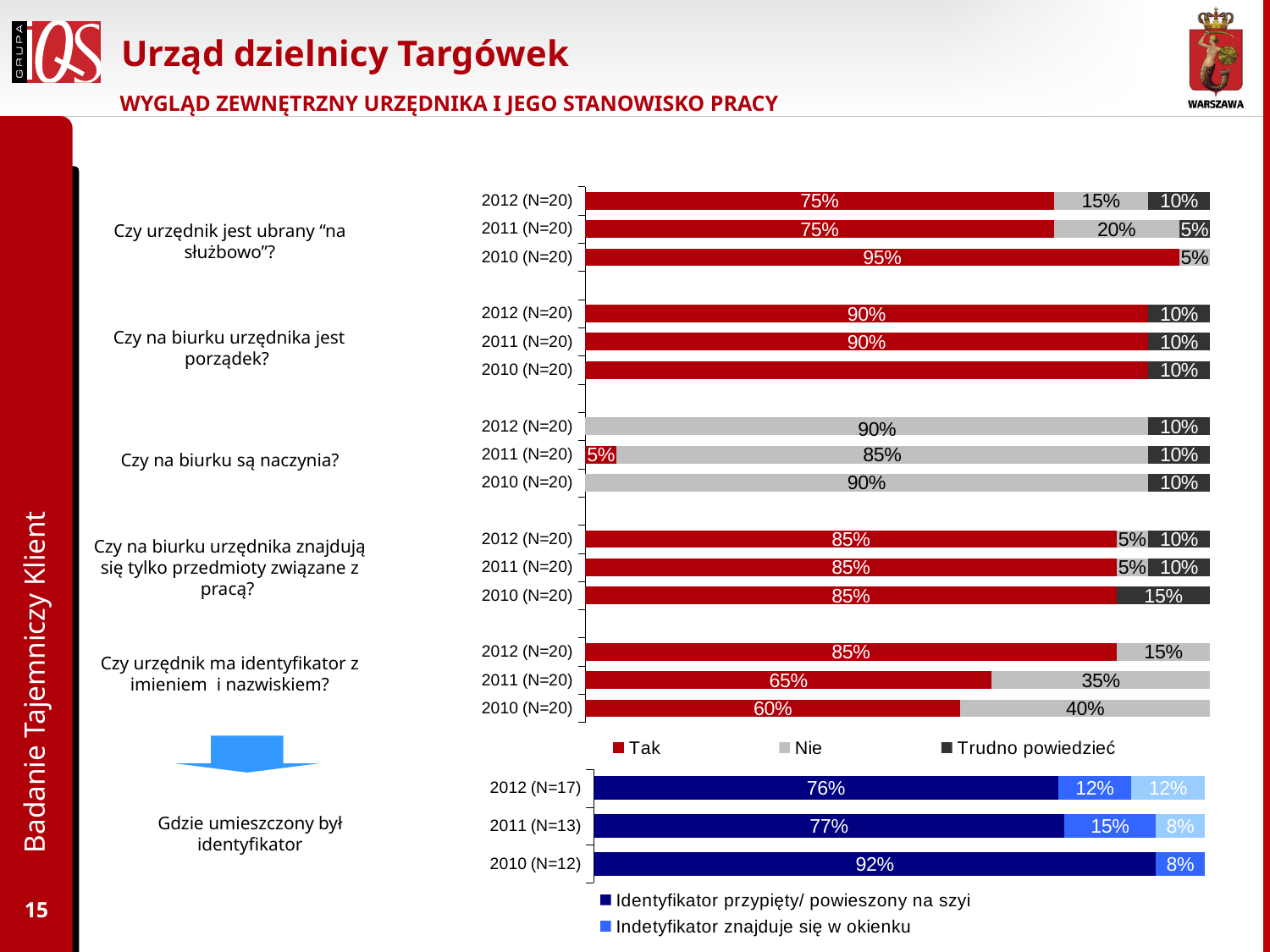
In the upper chart, what percentage answered "Tak" to "Czy urzędnik ma identyfikator z imieniem i nazwiskiem?" in 2010 (N=20)? 60% In the upper chart, for "Czy urzędnik ma identyfikator z imieniem i nazwiskiem?", does the "Tak" share rise or fall from 2010 to 2012? rise How many series does the legend of the upper chart list? 3 In the upper chart, what percentage answered "Tak" to "Czy urzędnik jest ubrany 'na służbowo'?" in 2010 (N=20)? 95% In the upper chart, what percentage answered "Tak" to "Czy na biurku są naczynia?" in 2011 (N=20)? 5% In the lower chart "Gdzie umieszczony był identyfikator", what percentage is "Indetyfikator znajduje się w okienku" in 2011 (N=13)? 15% In the upper chart, which is larger: the "Nie" share for "Czy urzędnik ma identyfikator z imieniem i nazwiskiem?" in 2010 or in 2011? 2010 In the upper chart, what percentage answered "Nie" to "Czy urzędnik jest ubrany 'na służbowo'?" in 2011 (N=20)? 20% In the upper chart, for "Czy urzędnik ma identyfikator z imieniem i nazwiskiem?", what is the difference between the "Tak" share in 2012 and in 2011? 20% In the lower chart "Gdzie umieszczony był identyfikator", what percentage is "Identyfikator przypięty/ powieszony na szyi" in 2010 (N=12)? 92% In the upper chart, for "Czy urzędnik ma identyfikator z imieniem i nazwiskiem?", which year has the highest "Tak" share? 2012 (N=20) What type of chart is the lower chart "Gdzie umieszczony był identyfikator"? stacked bar chart